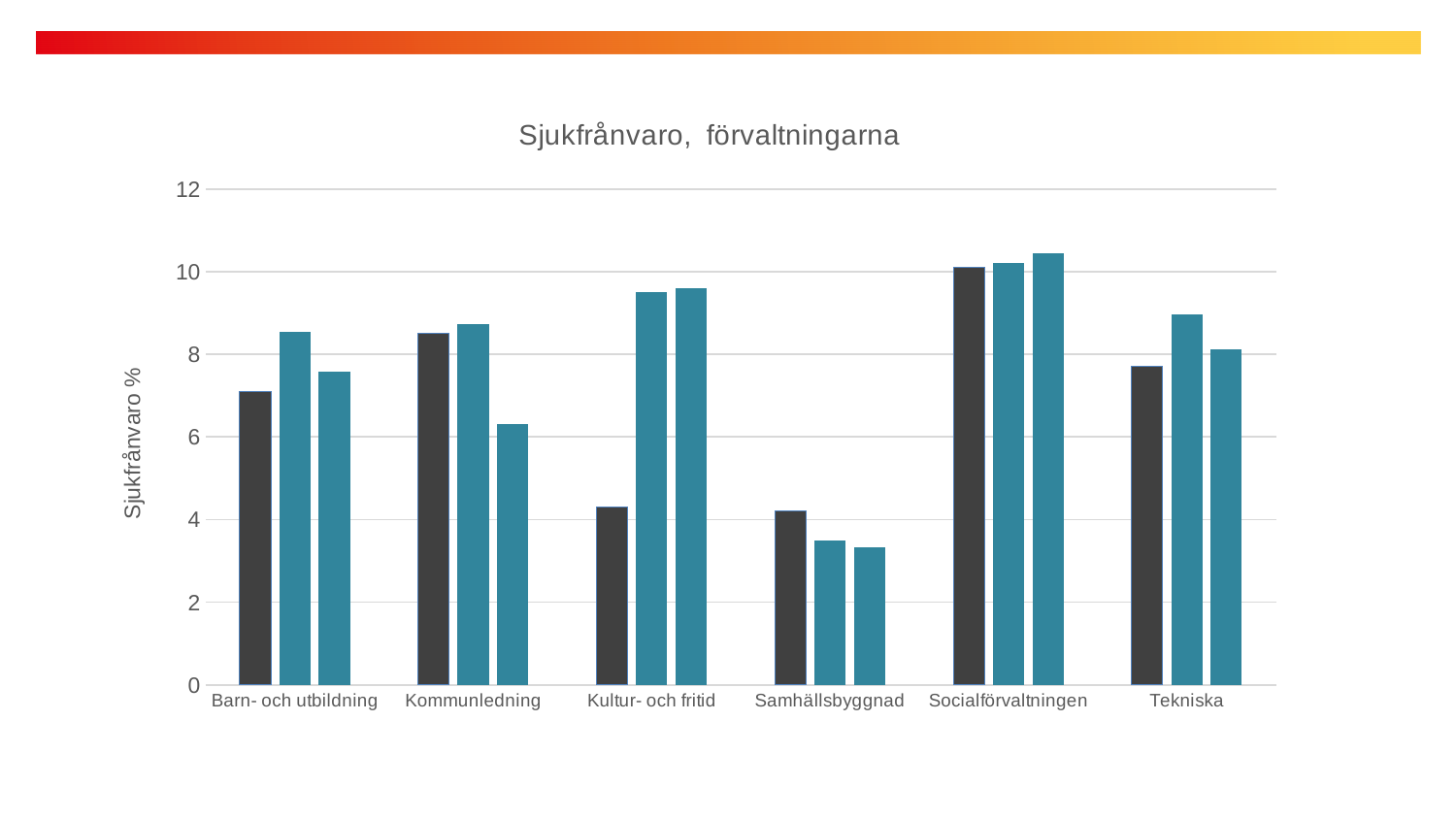
What kind of chart is shown on the slide? bar chart What is the title of the chart? Sjukfrånvaro, förvaltningarna How many bars are plotted for each category? 3 How many categories (förvaltningar) are shown on the x axis? 6 Which category has the tallest bars overall? Socialförvaltningen Is the dark grey bar for Socialförvaltningen greater or less than 8? greater Is the dark grey bar for Samhällsbyggnad greater or less than 6? less What is the label on the vertical axis? Sjukfrånvaro % Is the middle (teal) bar for Kultur- och fritid greater or less than 8? greater Which is larger: the third bar for Barn- och utbildning or the third bar for Kommunledning? Barn- och utbildning Which category has the lowest bars overall? Samhällsbyggnad Which is larger: the dark grey bar for Kommunledning or the dark grey bar for Kultur- och fritid? Kommunledning